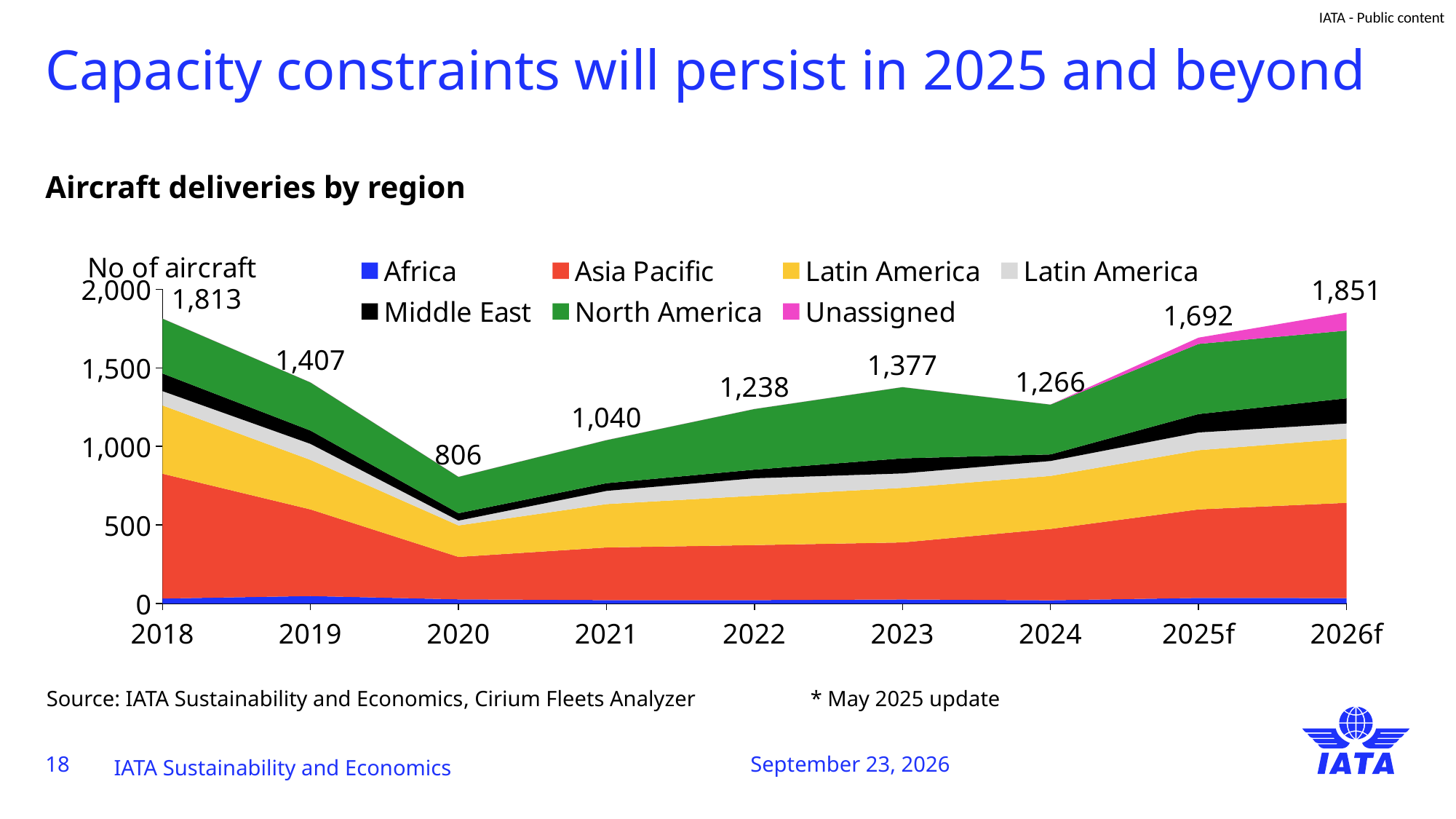
How many years are shown on the x axis? 9 Which year has the lowest total aircraft deliveries? 2020 What is the total number of aircraft deliveries shown for 2020? 806 What is the total number of aircraft deliveries shown for 2018? 1,813 Do total aircraft deliveries rise or fall from 2020 to 2023? Rise Which year has the highest total aircraft deliveries? 2026f What is the difference between the total deliveries in 2026f and 2025f? 159 What kind of chart is shown on the slide? Stacked area chart Which year has a higher total of aircraft deliveries, 2023 or 2024? 2023 Is the Asia Pacific value for 2018 greater or less than 500? greater How many series does the legend list? 7 What is the total number of aircraft deliveries forecast for 2026f? 1,851